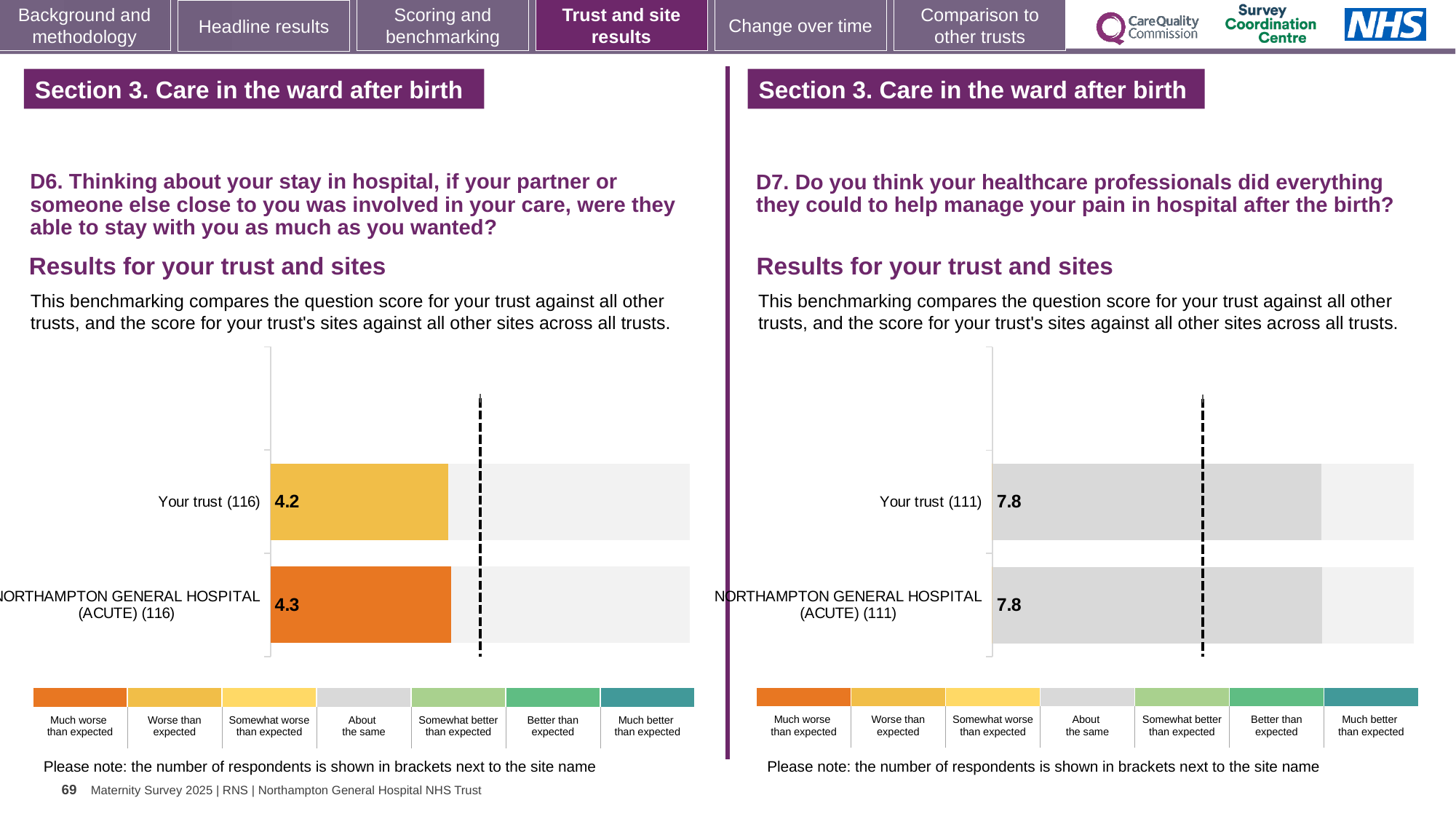
How many bars are plotted on the D6 chart (left)? 2 On the D6 chart (left), what is the score for NORTHAMPTON GENERAL HOSPITAL (ACUTE) (116)? 4.3 On the D7 chart (right), which benchmark category does the colour of the Your trust (111) bar correspond to in the legend? About the same On the D7 chart (right), what is the score for NORTHAMPTON GENERAL HOSPITAL (ACUTE) (111)? 7.8 How many bars are plotted on the D7 chart (right)? 2 On the D6 chart (left), which benchmark category does the colour of the Your trust (116) bar correspond to in the legend? Worse than expected On the D7 chart (right), what is the score for Your trust (111)? 7.8 On the D6 chart (left), what is the difference between the score for NORTHAMPTON GENERAL HOSPITAL (ACUTE) (116) and the score for Your trust (116)? 0.1 On the D7 chart (right), what is the difference between the score for Your trust (111) and the score for NORTHAMPTON GENERAL HOSPITAL (ACUTE) (111)? 0 On the D6 chart (left), what is the score for Your trust (116)? 4.2 On the D6 chart (left), which has the higher score: Your trust (116) or NORTHAMPTON GENERAL HOSPITAL (ACUTE) (116)? NORTHAMPTON GENERAL HOSPITAL (ACUTE) (116) What type of chart is used on the D7 chart (right)? Bar chart